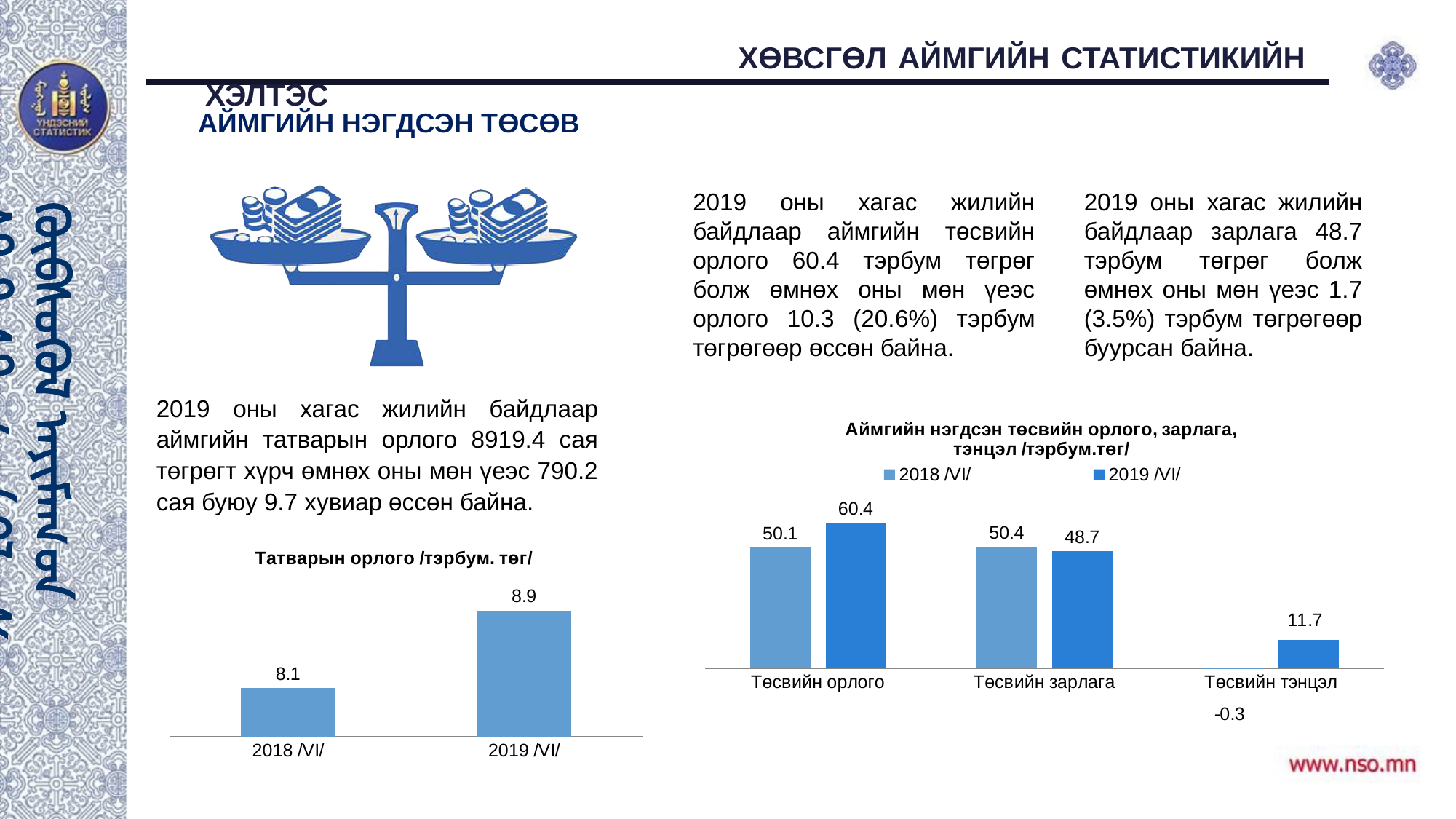
In the chart titled 'Аймгийн нэгдсэн төсвийн орлого, зарлага, тэнцэл /тэрбум.төг/', what is the 2018 /VI/ value for Төсвийн тэнцэл? -0.3 In the chart titled 'Аймгийн нэгдсэн төсвийн орлого, зарлага, тэнцэл /тэрбум.төг/', how many categories are shown on the x axis? 3 In the chart titled 'Татварын орлого /тэрбум. төг/', what is the value for 2018 /VI/? 8.1 In the chart titled 'Аймгийн нэгдсэн төсвийн орлого, зарлага, тэнцэл /тэрбум.төг/', what is the 2018 /VI/ value for Төсвийн зарлага? 50.4 In the chart titled 'Татварын орлого /тэрбум. төг/', what is the value for 2019 /VI/? 8.9 In the chart titled 'Аймгийн нэгдсэн төсвийн орлого, зарлага, тэнцэл /тэрбум.төг/', which category has the highest 2019 /VI/ value? Төсвийн орлого In the chart titled 'Аймгийн нэгдсэн төсвийн орлого, зарлага, тэнцэл /тэрбум.төг/', how many series does the legend list? 2 What kind of chart is the one titled 'Татварын орлого /тэрбум. төг/'? bar chart In the chart titled 'Татварын орлого /тэрбум. төг/', what is the difference between the 2019 /VI/ and 2018 /VI/ values? 0.8 In the chart titled 'Аймгийн нэгдсэн төсвийн орлого, зарлага, тэнцэл /тэрбум.төг/', what is the difference between the 2019 /VI/ and 2018 /VI/ values for Төсвийн орлого? 10.3 In the chart titled 'Аймгийн нэгдсэн төсвийн орлого, зарлага, тэнцэл /тэрбум.төг/', what is the 2019 /VI/ value for Төсвийн орлого? 60.4 In the chart titled 'Татварын орлого /тэрбум. төг/', do the values rise or fall from 2018 /VI/ to 2019 /VI/? rise